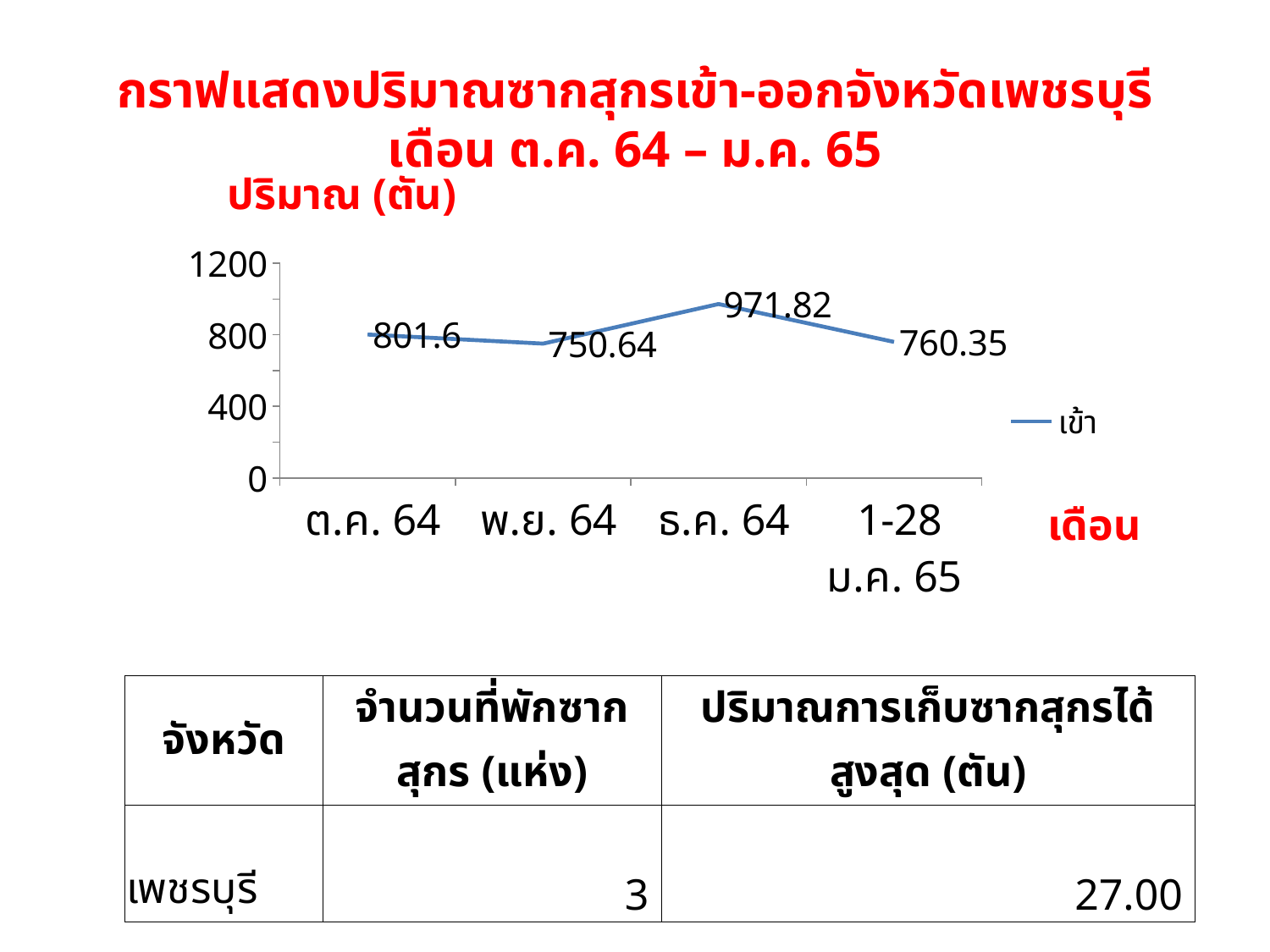
What is the value for ต.ค. 64 in the line chart? 801.6 Is the value for ธ.ค. 64 greater or less than 800? greater What type of chart is shown on the slide? line chart What is the difference between the values for ธ.ค. 64 and พ.ย. 64? 221.18 Which is larger, the value for ต.ค. 64 or the value for 1-28 ม.ค. 65? ต.ค. 64 What is the value for 1-28 ม.ค. 65 in the line chart? 760.35 Which month has the lowest value in the line chart? พ.ย. 64 How many series does the legend of the chart list? 1 Which month has the highest value in the line chart? ธ.ค. 64 How many data points are plotted in the line chart? 4 What is the value for ธ.ค. 64 in the line chart? 971.82 What is the value for พ.ย. 64 in the line chart? 750.64